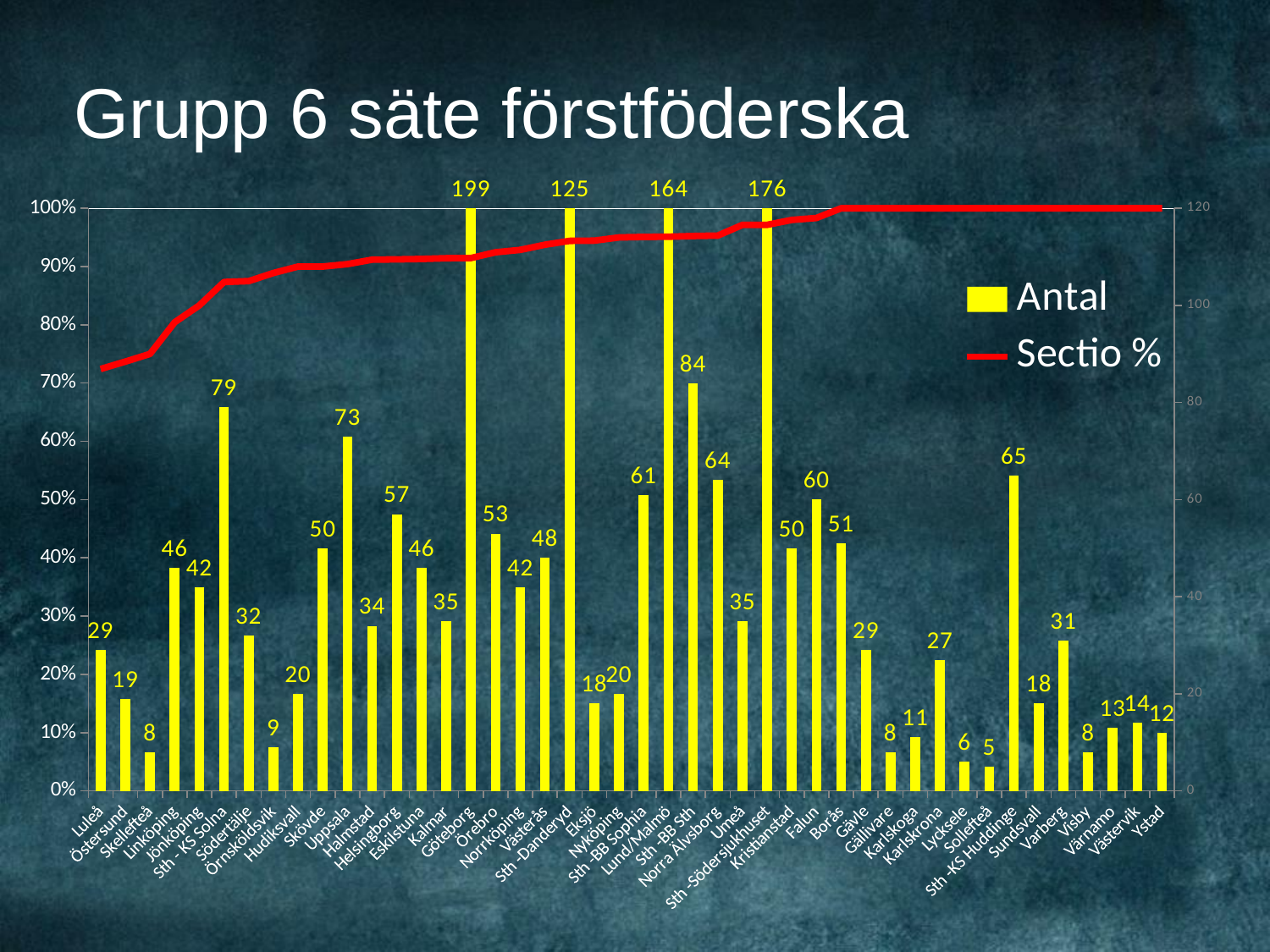
Which category has the lowest Antal value? Sollefteå What is the Antal value for Uppsala? 73 What is the difference between the Antal values for Göteborg and Lund/Malmö? 35 Does the Sectio % line rise or fall along the x axis? rises How many categories are shown on the x axis? 44 What is the Antal value for Sth -KS Huddinge? 65 Which has the larger Antal value, Helsingborg or Falun? Falun Which category has the highest Antal value? Göteborg How many series does the legend list? 2 What kind of chart is shown on the slide? bar chart with a line Is the Sectio % value for Luleå greater or less than 80%? less What is the Antal value for Sth -Södersjukhuset? 176